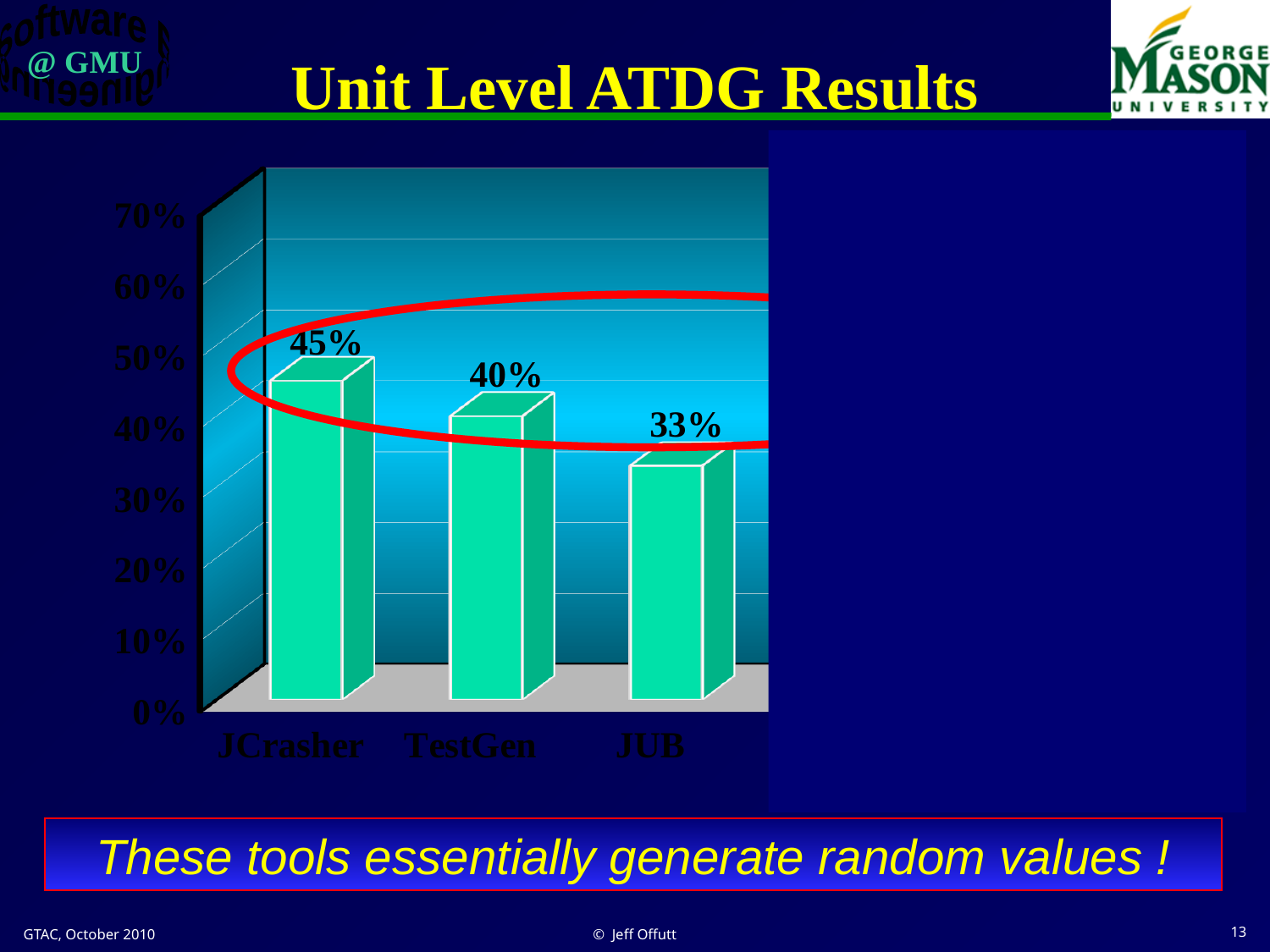
What is the difference between the values for JCrasher and JUB? 12% Do the values rise or fall from left to right across the tools? fall How many tools are shown on the chart? 3 What is the difference between the values for TestGen and JUB? 7% Which tool has the highest value? JCrasher Is the value for JUB greater or less than 40%? less What value is shown for JCrasher? 45% What value is shown for TestGen? 40% What kind of chart is shown on the slide? bar chart What value is shown for JUB? 33% Which is larger, the value for TestGen or the value for JUB? TestGen Which tool has the lowest value? JUB